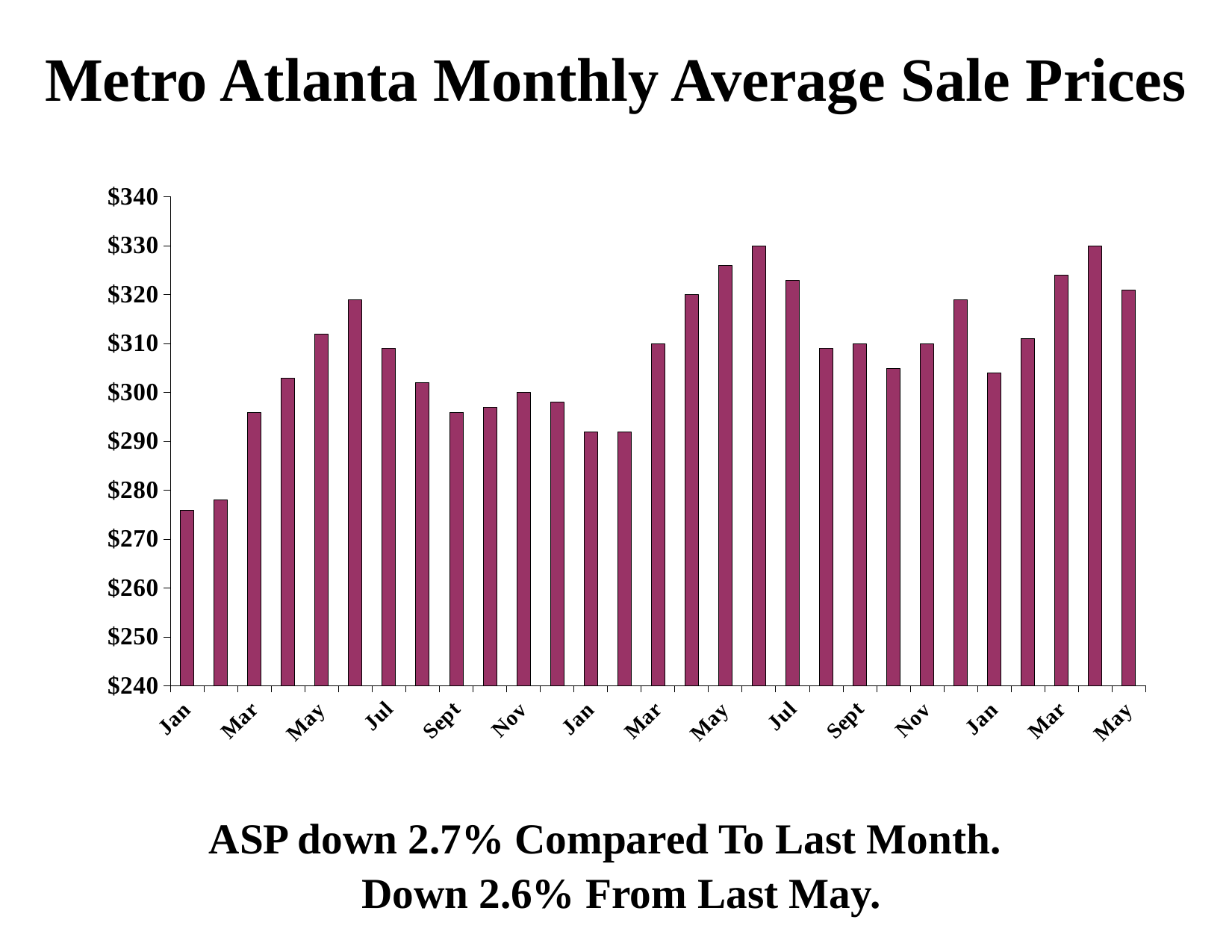
Is the value for the second May on the x axis greater or less than $320? greater What is the title of the chart? Metro Atlanta Monthly Average Sale Prices Is the value for the last May on the x axis greater or less than $330? less Is the value for the second Jan on the x axis greater or less than $300? less How many bars are plotted in the chart? 29 Do the values rise or fall from the first Jan to the first Jul on the x axis? rise Which is larger, the value for the first Jan or the value for the last May on the x axis? the last May What is the lowest value shown on the vertical axis? $240 What kind of chart is shown on the slide? bar chart Which is larger, the value for the first May or the value for the second May on the x axis? the second May